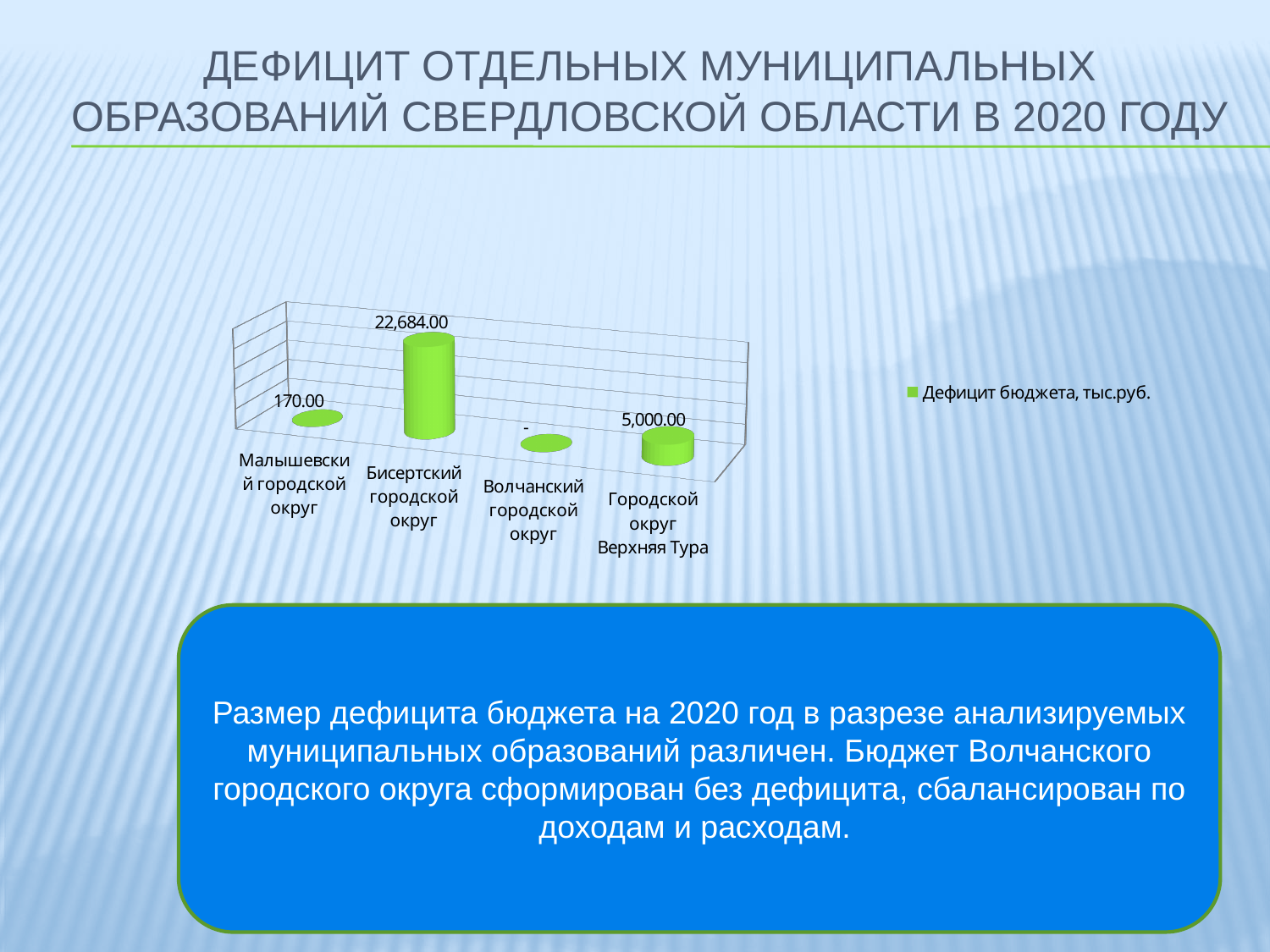
What is the difference between the budget deficit of Бисертский городской округ and Городской округ Верхняя Тура? 17,684.00 Which municipality has the highest budget deficit on the chart? Бисертский городской округ What data label is shown for Волчанский городской округ? - What is the budget deficit value shown for Бисертский городской округ? 22,684.00 What is the difference between the budget deficit of Городской округ Верхняя Тура and Малышевский городской округ? 4,830.00 Which municipality has the lowest budget deficit on the chart? Волчанский городской округ What is the budget deficit value shown for Городской округ Верхняя Тура? 5,000.00 How many municipalities are shown on the chart? 4 What kind of chart is shown on the slide? Bar chart Which has a larger budget deficit: Малышевский городской округ or Городской округ Верхняя Тура? Городской округ Верхняя Тура What is the budget deficit value shown for Малышевский городской округ? 170.00 How many series does the chart legend list? 1